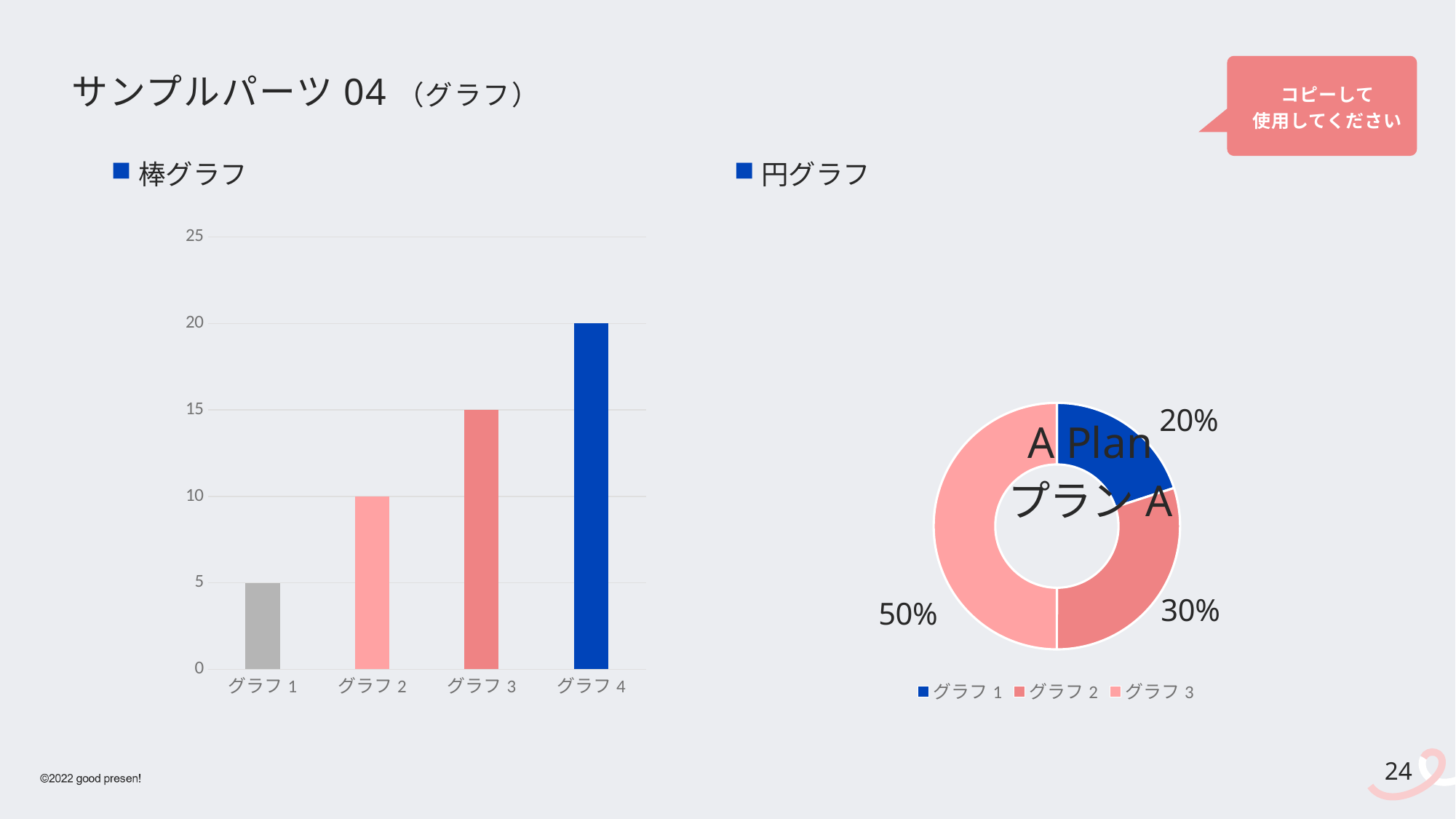
In the bar chart on the left, do the values rise or fall from グラフ 1 to グラフ 4? rise In the bar chart on the left, what is the value for グラフ 4? 20 In the pie chart on the right, which slice is the smallest? グラフ 1 In the pie chart on the right, what share does グラフ 3 have? 50% In the pie chart on the right, which is larger, グラフ 2 or グラフ 1? グラフ 2 In the bar chart on the left, what is the value for グラフ 1? 5 How many entries does the legend of the pie chart on the right list? 3 How many categories are shown in the bar chart on the left? 4 In the bar chart on the left, which category has the lowest value? グラフ 1 In the bar chart on the left, which category has the highest value? グラフ 4 What kind of chart is shown on the left side of the slide? bar chart In the bar chart on the left, what is the difference between the values for グラフ 3 and グラフ 2? 5